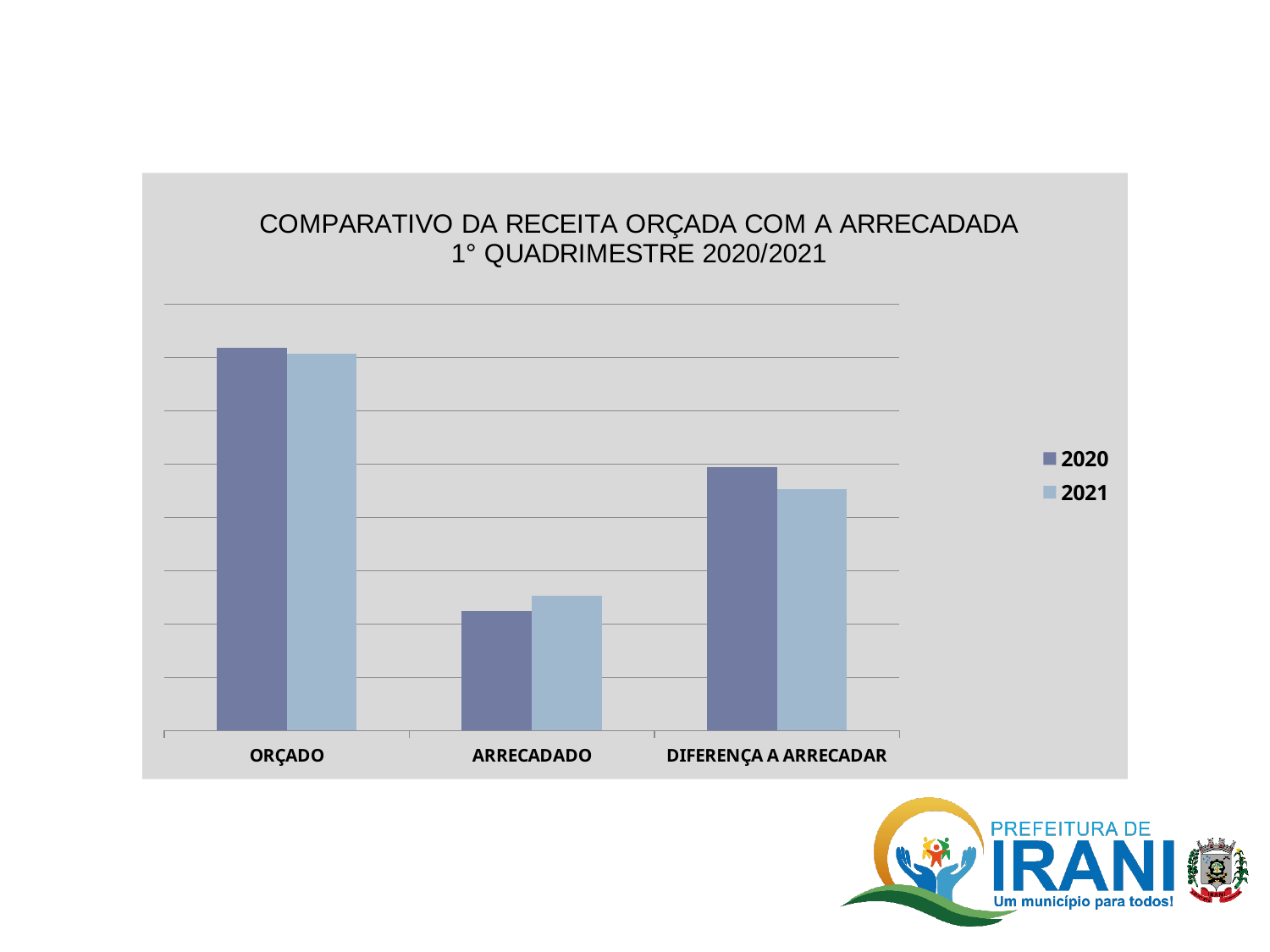
Which category has the lowest value for the 2020 series? ARRECADADO How many series does the legend list? 2 Which series is shown in the lighter blue colour? 2021 For ARRECADADO, which series has the larger value, 2020 or 2021? 2021 Which category has the highest value for the 2021 series? ORÇADO What is the title of the chart? COMPARATIVO DA RECEITA ORÇADA COM A ARRECADADA 1° QUADRIMESTRE 2020/2021 Which category has the lowest value for the 2021 series? ARRECADADO What kind of chart is shown on the slide? bar chart Does the 2020 series rise or fall from ORÇADO to ARRECADADO? fall Which category has the highest value for the 2020 series? ORÇADO For DIFERENÇA A ARRECADAR, which series has the larger value, 2020 or 2021? 2020 How many categories are shown on the x axis of the chart? 3